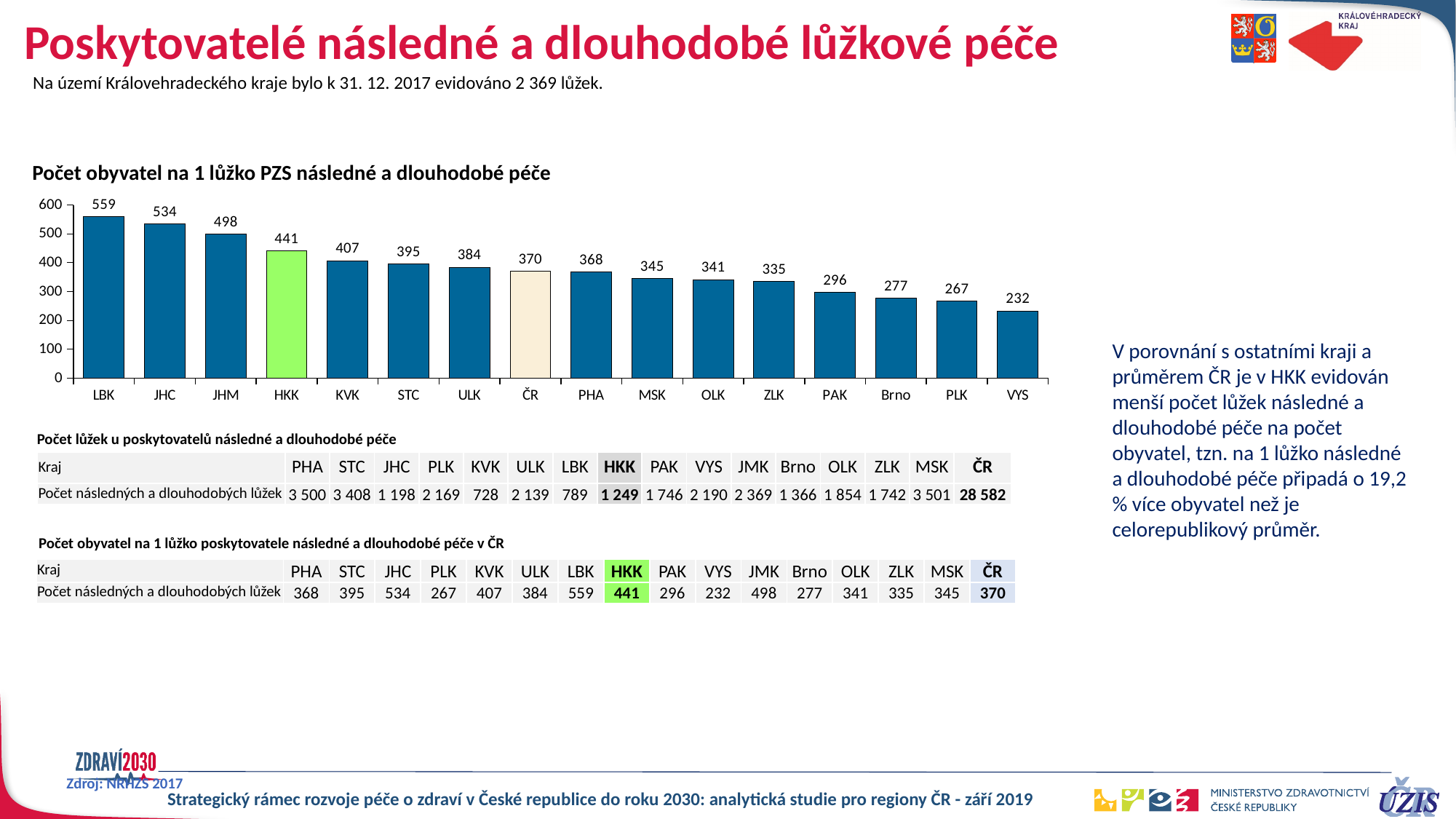
Which category has the lowest value in the chart? VYS Which category has the highest value in the chart? LBK What is the difference between the values for HKK and ČR in the chart? 71 Which is larger in the chart, the value for JHC or the value for JHM? JHC What is the value for VYS in the chart? 232 Do the values in the chart rise or fall from left to right along the x axis? fall What kind of chart is shown on the slide? bar chart What is the value for HKK in the chart? 441 How many bars are shown in the chart? 16 Is the value for PAK in the chart greater or less than 300? less What is the value for ČR in the chart? 370 What is the difference between the values for LBK and VYS in the chart? 327